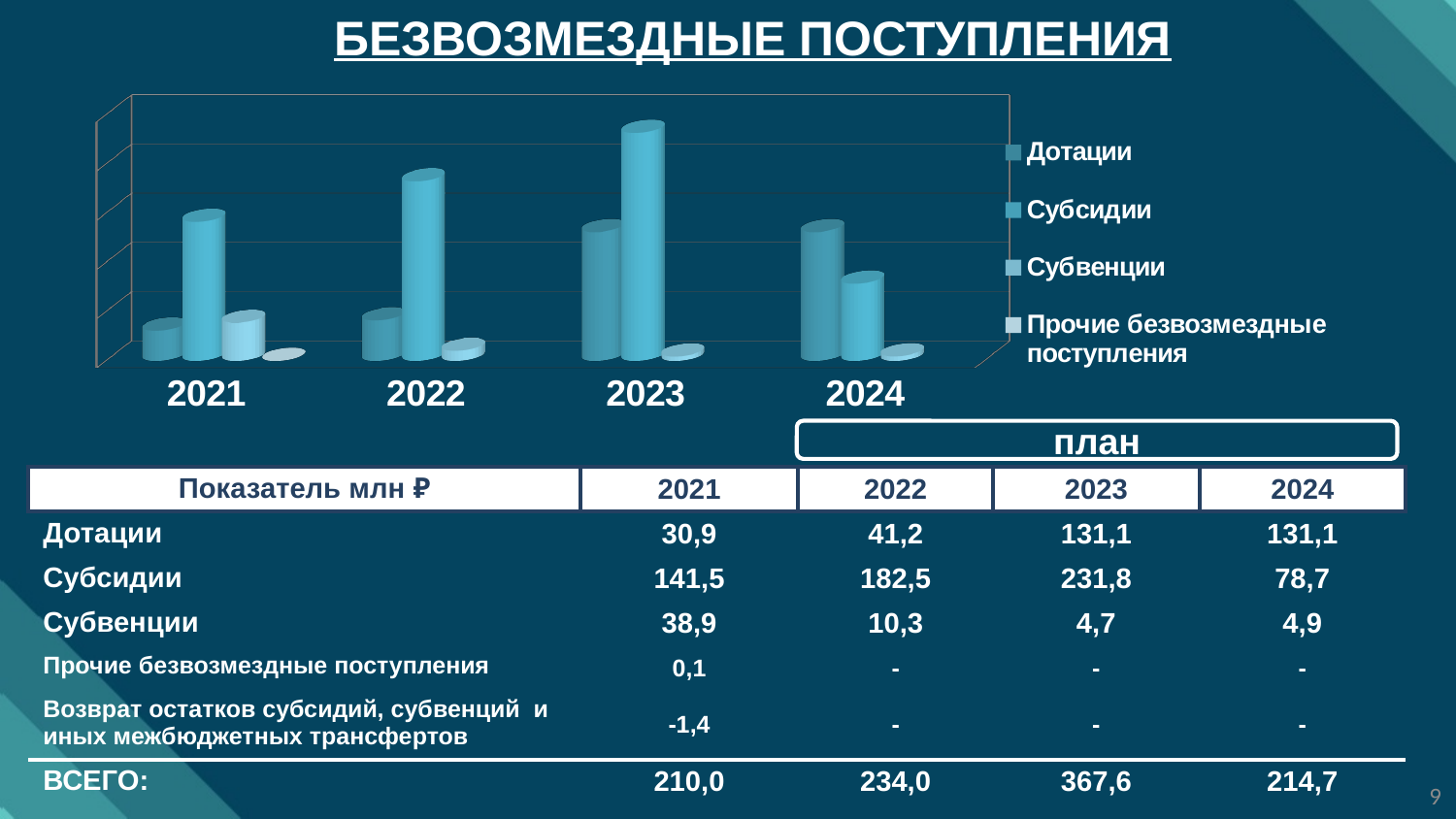
What is the value of Субсидии for 2023? 231,8 What kind of chart is shown on the slide? bar chart In which year is the Субсидии value the lowest? 2024 What is the value of Дотации for 2021? 30,9 How many years are shown along the x axis of the chart? 4 In which year is the Субсидии value the highest? 2023 Do the Субвенции values rise or fall from 2021 to 2023? fall How many series does the chart legend list? 4 What is the title of the slide containing the chart? БЕЗВОЗМЕЗДНЫЕ ПОСТУПЛЕНИЯ For 2024, which is larger: Дотации or Субсидии? Дотации What is the difference between the Субсидии values for 2023 and 2022? 49,3 What is the value of Субвенции for 2022? 10,3